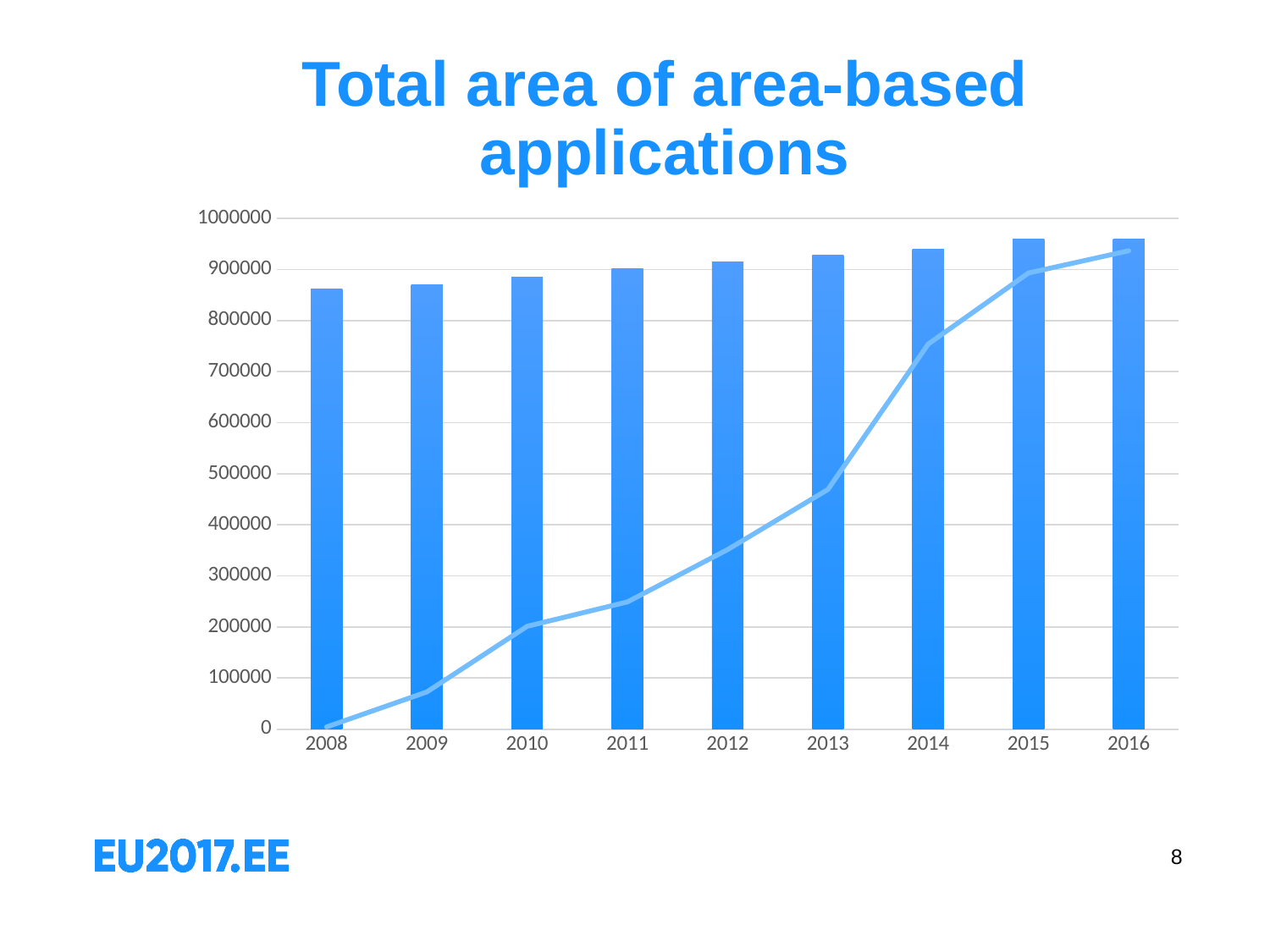
Do the bar values rise or fall from 2008 to 2016? Rise Which year has the lowest bar in the chart? 2008 Is the bar value for 2008 greater or less than 900000? less In which year does the line reach its highest point? 2016 Which bar is taller, 2008 or 2013? 2013 How many years are shown on the x axis of the chart? 9 What kind of chart is shown on the slide? Bar chart with a line Is the bar value for 2015 greater or less than 900000? greater Does the line rise or fall from 2008 to 2016? Rise What is the title of the chart? Total area of area-based applications Is the line value for 2013 greater or less than 500000? less